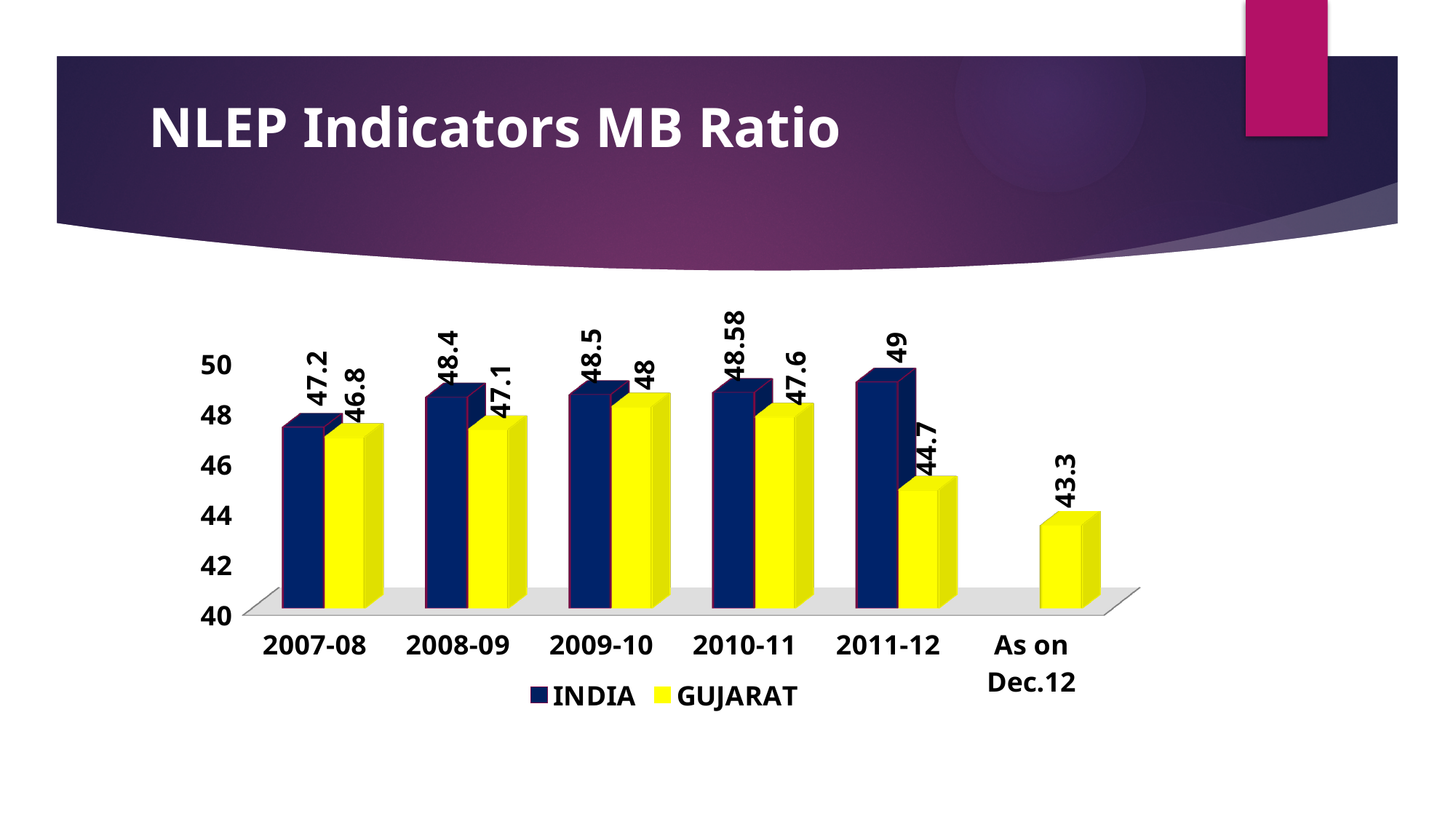
In which period is the GUJARAT value lowest? As on Dec.12 What is the difference between the INDIA and GUJARAT values in 2011-12? 4.3 Which colour represents GUJARAT in the chart? Yellow What is the value for GUJARAT in 2010-11? 47.6 What is the value for GUJARAT as on Dec.12? 43.3 What is the value for INDIA in 2007-08? 47.2 What kind of chart is shown on the slide? Bar chart What is the value for INDIA in 2011-12? 49 In which period is the INDIA value highest? 2011-12 Which is larger in 2009-10, the INDIA value or the GUJARAT value? INDIA How many periods are shown on the x axis? 6 How many series does the legend list? 2